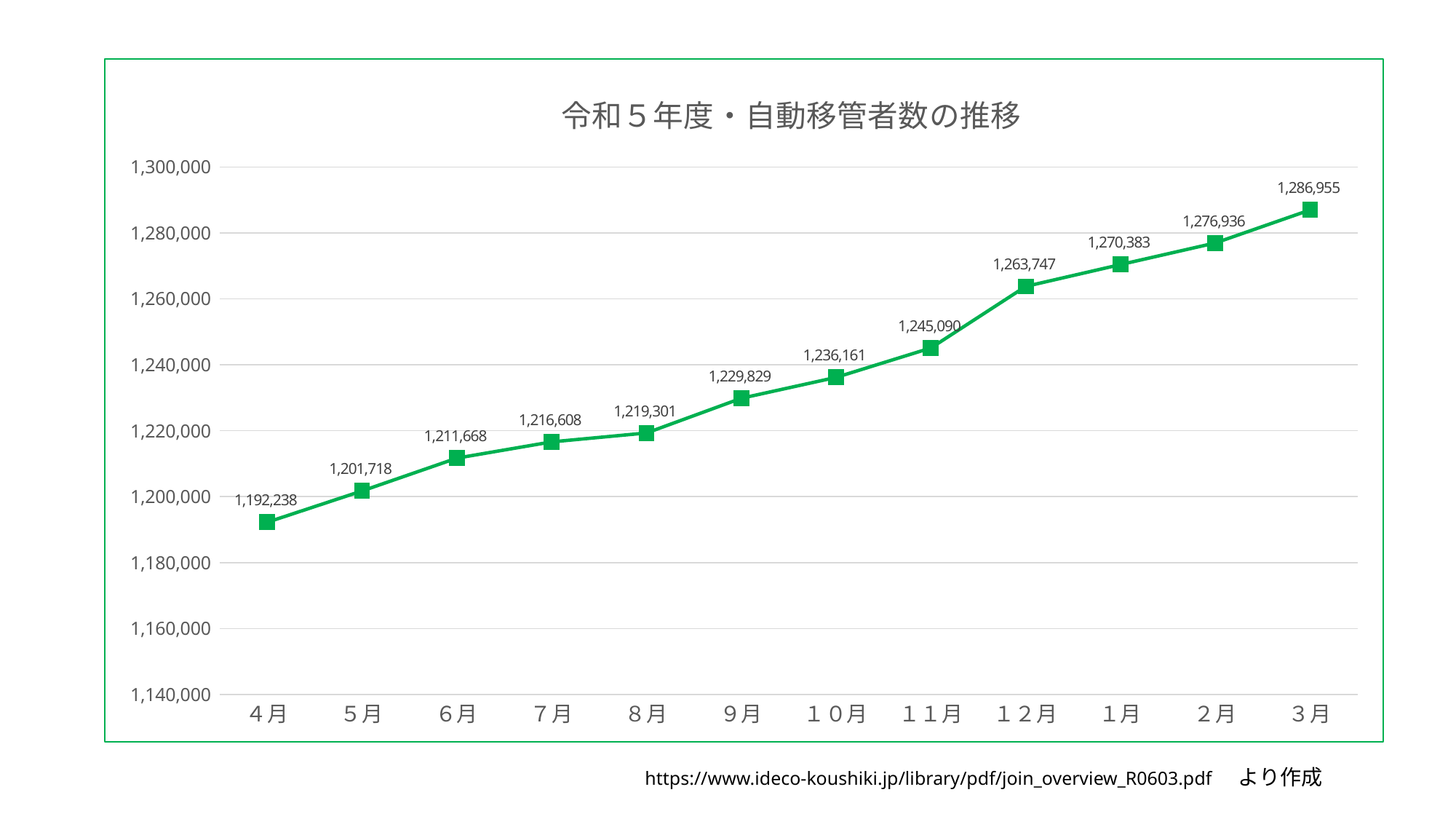
What is the difference between the values for 12月 and 11月? 18,657 How many months are plotted on the chart? 12 Which month has the lowest value? 4月 Which month has the highest value? 3月 What is the value for 12月? 1,263,747 What is the difference between the values for 3月 and 4月? 94,717 Is the value for 1月 greater or less than 1,260,000? greater What is the value for 9月? 1,229,829 What is the value for 4月? 1,192,238 What kind of chart is shown on the slide? line chart Which is larger, the value for 7月 or the value for 10月? 10月 Do the values rise or fall from 4月 to 3月? rise